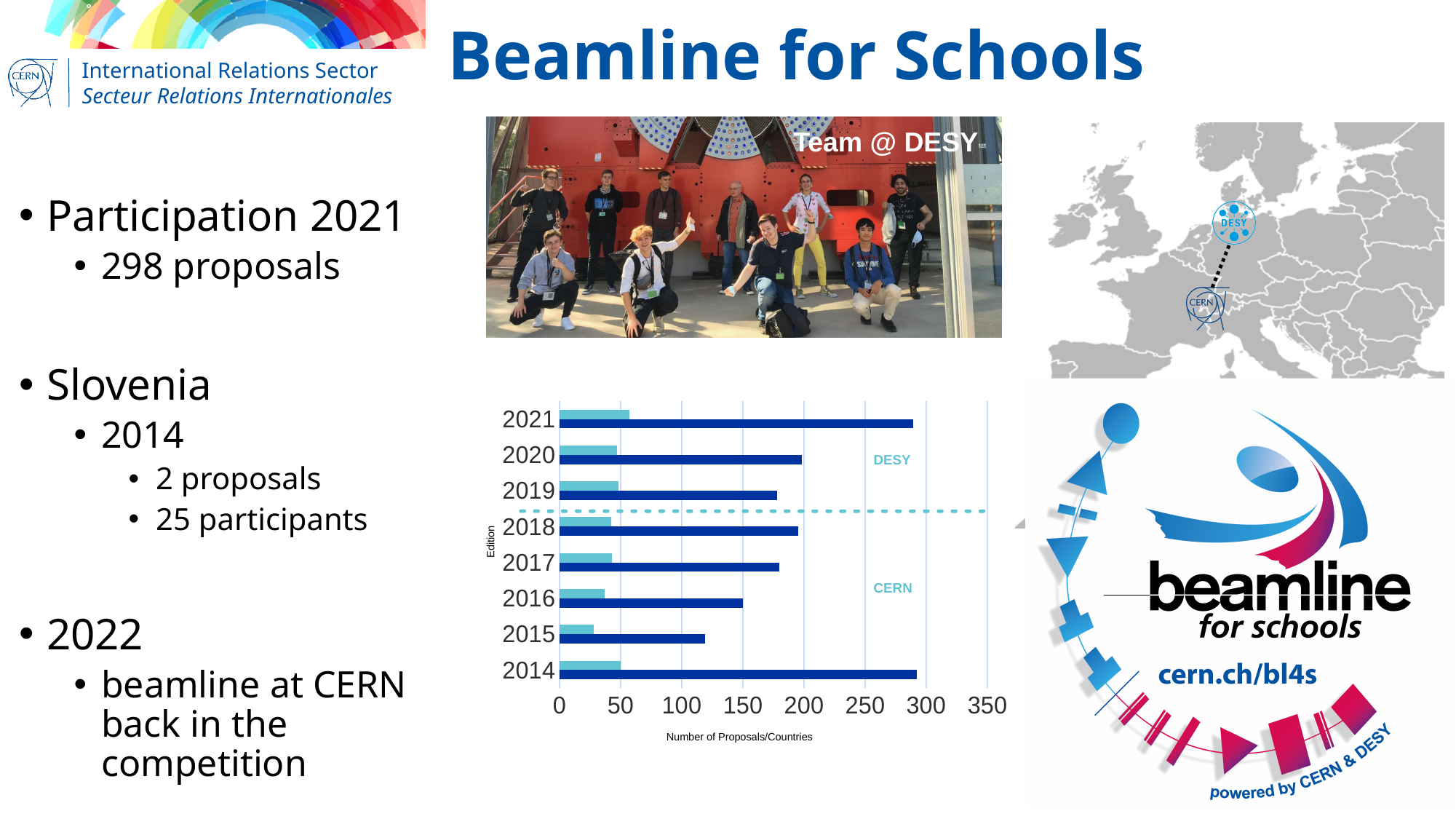
Which has the longer dark blue bar, 2020 or 2016? 2020 Is the light blue bar for 2015 greater or less than 50? less What is the label of the horizontal axis of the chart? Number of Proposals/Countries How many editions (years) are listed on the vertical axis of the chart? 8 Is the dark blue bar for 2021 greater or less than 250? greater Which edition has the shortest light blue bar? 2015 Is the dark blue bar for 2015 greater or less than 150? less Which editions on the chart are grouped under the label DESY? 2019, 2020 and 2021 What kind of chart is shown on the slide? bar chart From 2015 to 2018, do the dark blue bars rise or fall? rise Which edition has the shortest dark blue bar? 2015